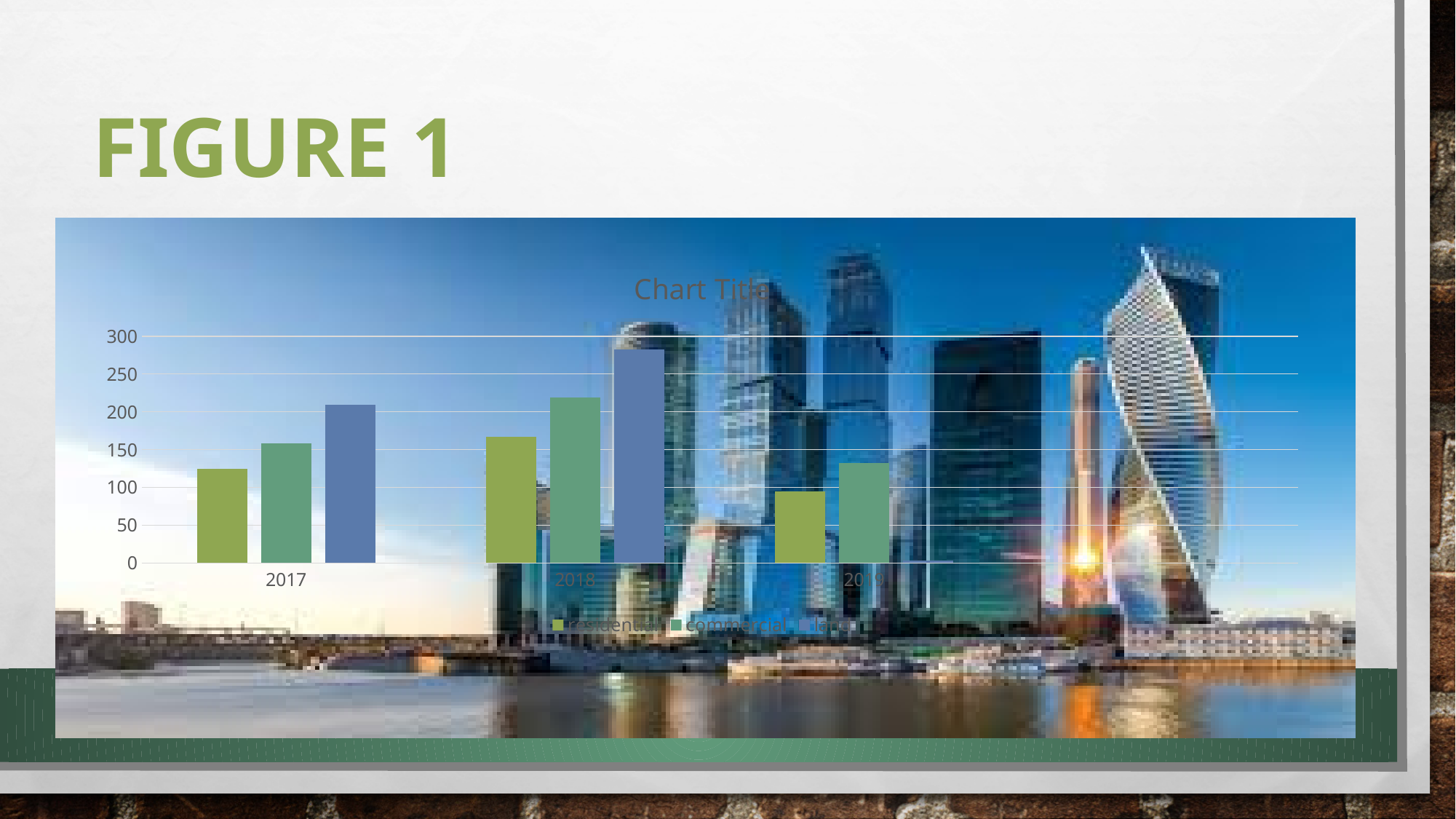
How many series does the chart legend list? 3 Does the commercial series rise or fall from 2018 to 2019? fall Which year has the highest land value? 2018 What is the title shown on the chart? Chart Title Is the residential value for 2017 greater or less than 150? less In 2017, which is larger, the residential value or the commercial value? commercial What kind of chart is shown on the slide? bar chart Is the commercial value for 2018 greater or less than 200? greater Which year has the lowest residential value? 2019 How many years are shown on the x axis of the chart? 3 Is the commercial value for 2019 greater or less than 100? greater